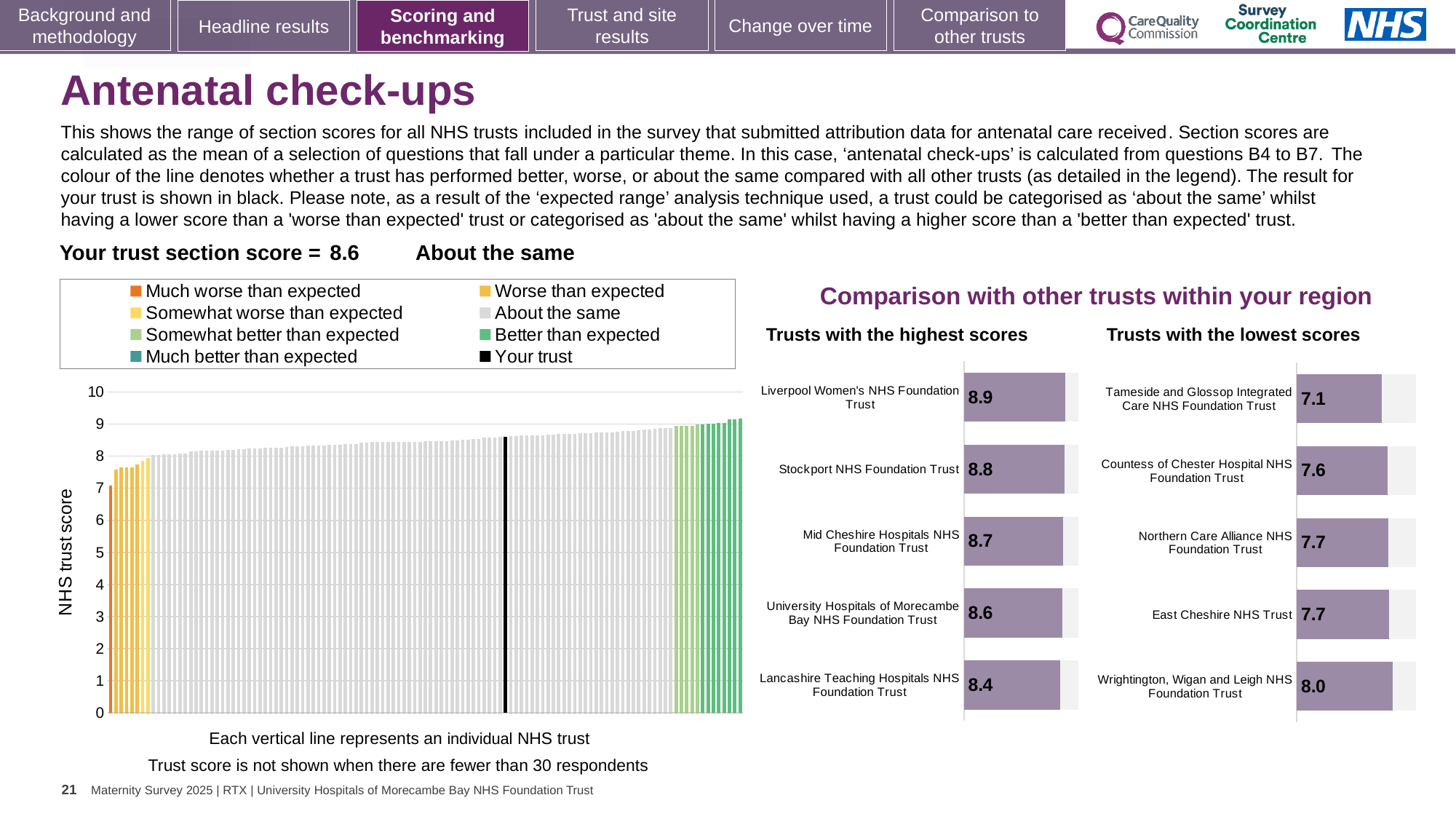
How many trusts are shown in the 'Trusts with the lowest scores' chart? 5 What kind of chart is the large chart on the left showing NHS trust scores? bar chart In the large chart on the left, is the value for the black 'Your trust' line greater or less than 8? greater In the 'Trusts with the highest scores' chart, what is the difference between the scores of Liverpool Women's NHS Foundation Trust and Lancashire Teaching Hospitals NHS Foundation Trust? 0.5 In the 'Trusts with the lowest scores' chart, which trust has the highest score? Wrightington, Wigan and Leigh NHS Foundation Trust In the 'Trusts with the highest scores' chart, what is the score for Liverpool Women's NHS Foundation Trust? 8.9 How many entries does the legend above the large chart on the left list? 8 In the 'Trusts with the lowest scores' chart, what is the difference between the scores of Wrightington, Wigan and Leigh NHS Foundation Trust and Tameside and Glossop Integrated Care NHS Foundation Trust? 0.9 In the 'Trusts with the lowest scores' chart, what is the score for Tameside and Glossop Integrated Care NHS Foundation Trust? 7.1 In the large chart on the left, do the trust scores rise or fall from left to right? rise In the 'Trusts with the highest scores' chart, which trust has the lowest score? Lancashire Teaching Hospitals NHS Foundation Trust In the 'Trusts with the highest scores' chart, which has the higher score: Stockport NHS Foundation Trust or Mid Cheshire Hospitals NHS Foundation Trust? Stockport NHS Foundation Trust